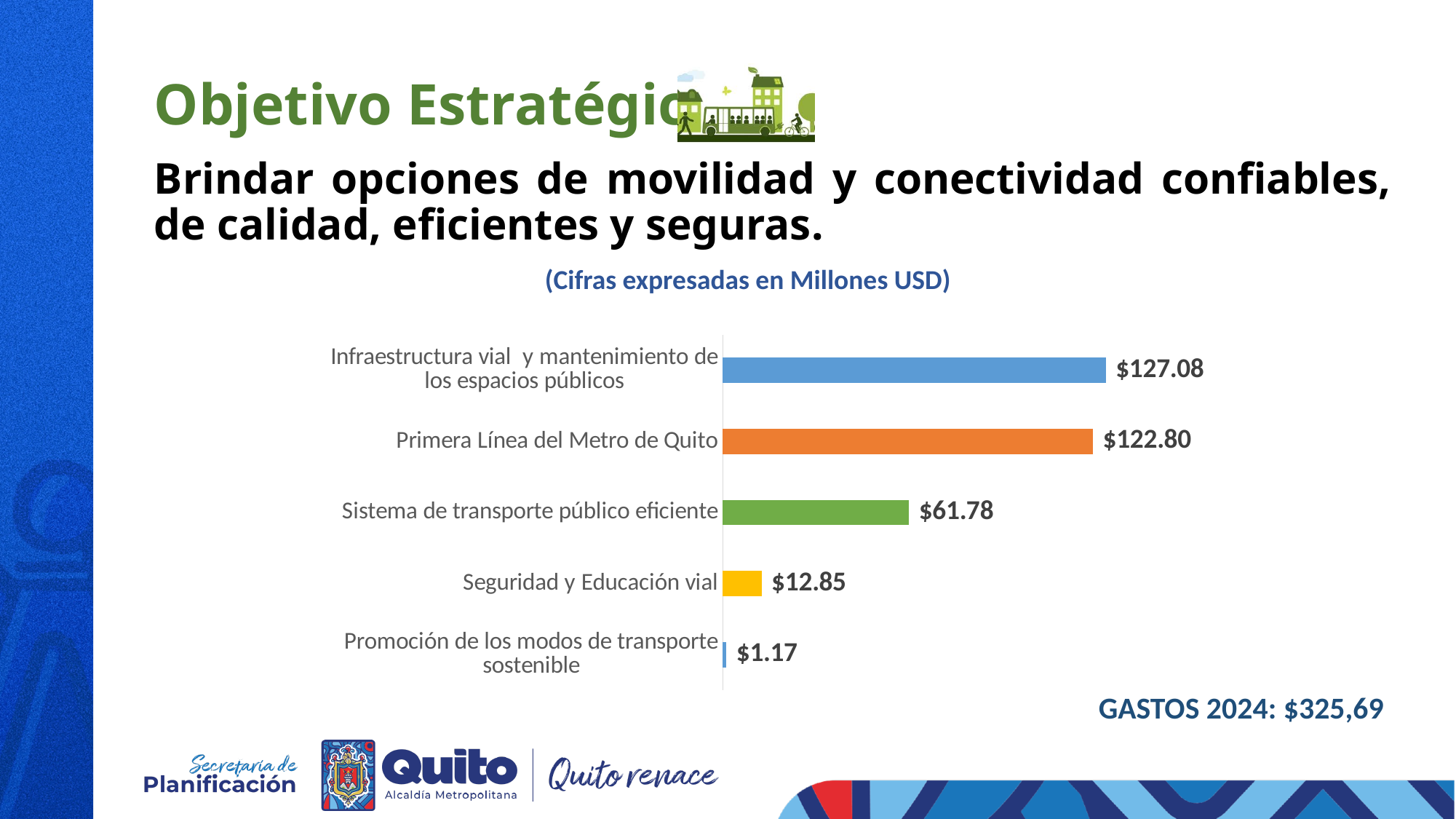
Which is larger, the value for Sistema de transporte público eficiente or the value for Seguridad y Educación vial? Sistema de transporte público eficiente How many categories are shown in the chart? 5 Which category has the lowest value? Promoción de los modos de transporte sostenible Which category has the highest value? Infraestructura vial y mantenimiento de los espacios públicos What kind of chart is shown on the slide? Bar chart What is the value for Sistema de transporte público eficiente? $61.78 What is the value for Seguridad y Educación vial? $12.85 In what units are the figures in the chart expressed, according to the slide? Millones USD What is the value for Promoción de los modos de transporte sostenible? $1.17 What is the difference between the values for Sistema de transporte público eficiente and Seguridad y Educación vial? $48.93 What is the value for Primera Línea del Metro de Quito? $122.80 What is the difference between the values for Infraestructura vial y mantenimiento de los espacios públicos and Primera Línea del Metro de Quito? $4.28